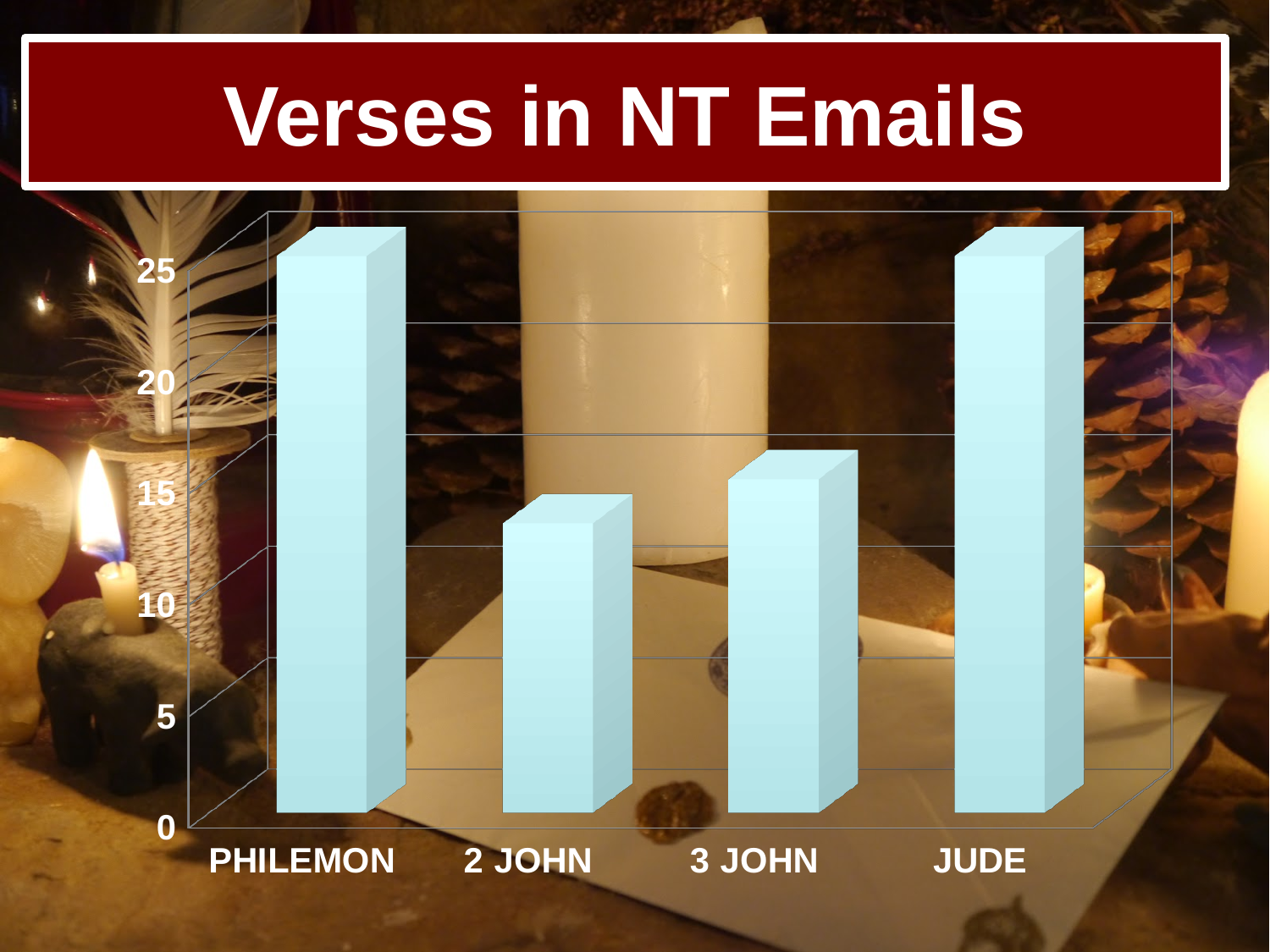
Is the value for 2 John greater or less than 10? greater Which has the larger value, Jude or 3 John? Jude Is the value for 3 John greater or less than 20? less Is the value for Philemon greater or less than 20? greater What is the title of the chart? Verses in NT Emails Which category has the lowest value in the chart? 2 John What kind of chart is shown on the slide? bar chart Which has the larger value, 2 John or 3 John? 3 John How many categories are shown on the x axis of the chart? 4 Which has the larger value, Philemon or 2 John? Philemon